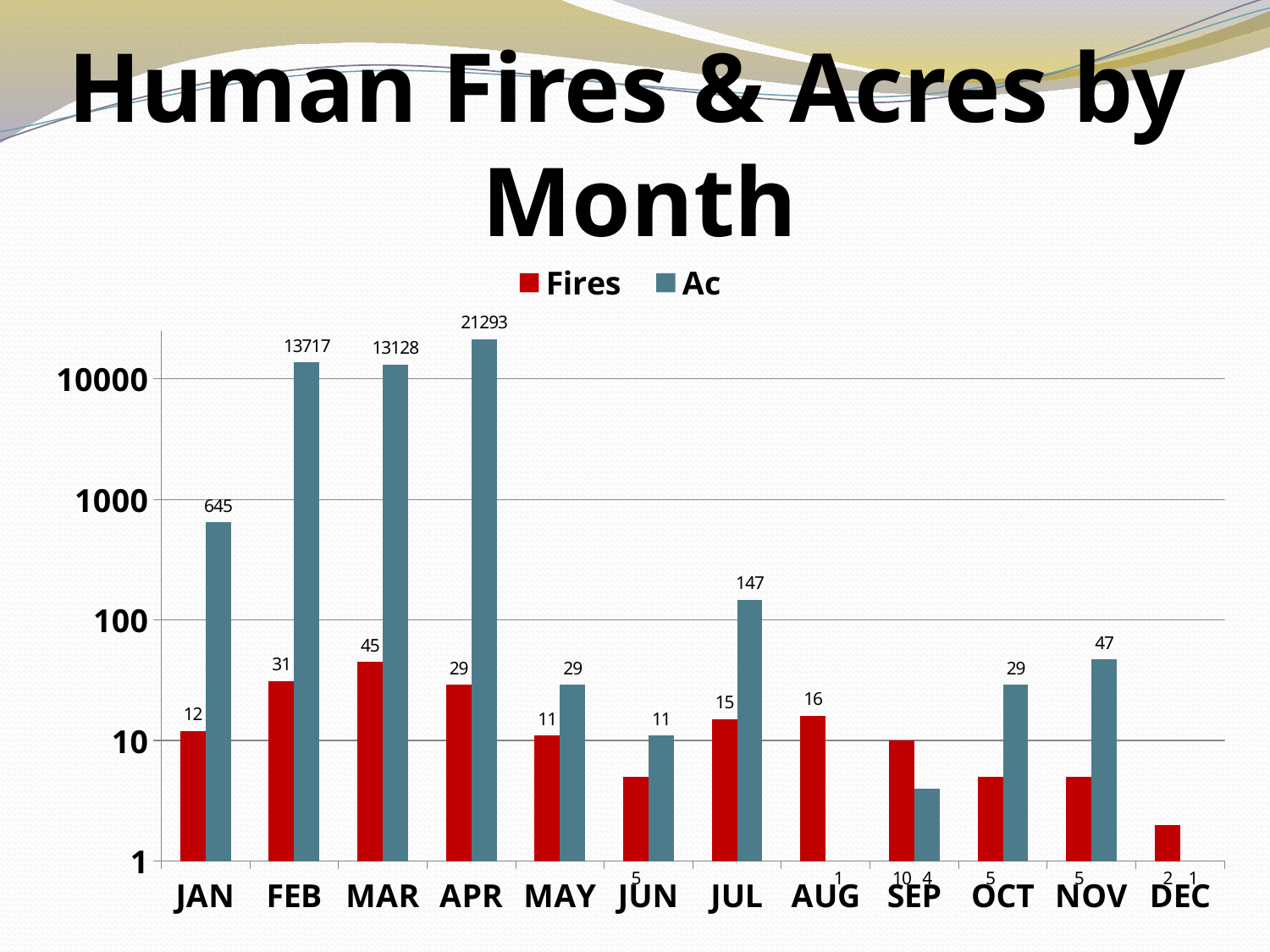
Which is larger, the Ac value for JAN or the Ac value for JUL? JAN What is the Ac value for APR? 21293 Is the Ac value for JAN greater or less than 1000? less What kind of chart is shown on the slide? bar chart What is the Ac value for JUL? 147 What is the difference between the Ac values for FEB and MAR? 589 What is the Fires value for MAR? 45 Which month has the highest Fires value? MAR How many months are shown on the x axis? 12 Which month has the highest Ac value? APR How many series does the legend list? 2 What colour are the bars for the Fires series? red